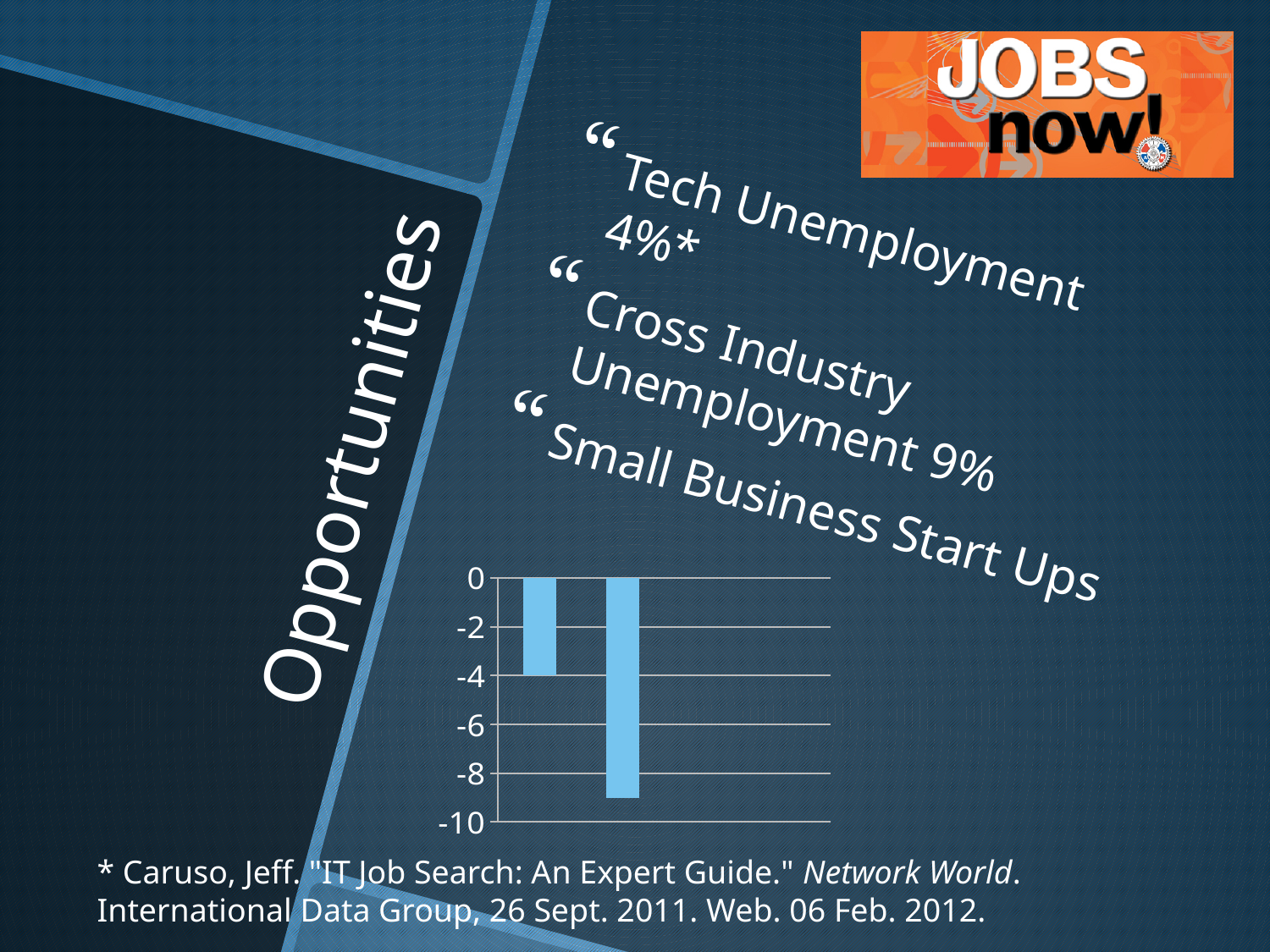
What is the lowest tick value shown on the chart's vertical axis? -10 Is the value of the left bar in the chart greater or less than -6? greater Do the bar values rise or fall from left to right across the chart? fall Which bar in the chart has the lowest value, the left or the right? the right bar How many bars does the chart contain? 2 What kind of chart is shown on the slide? bar chart What value does the left bar in the chart reach? -4 What colour are the bars in the chart? light blue Is the value of the right bar in the chart greater or less than -8? less Which bar in the chart has the higher value, the left or the right? the left bar